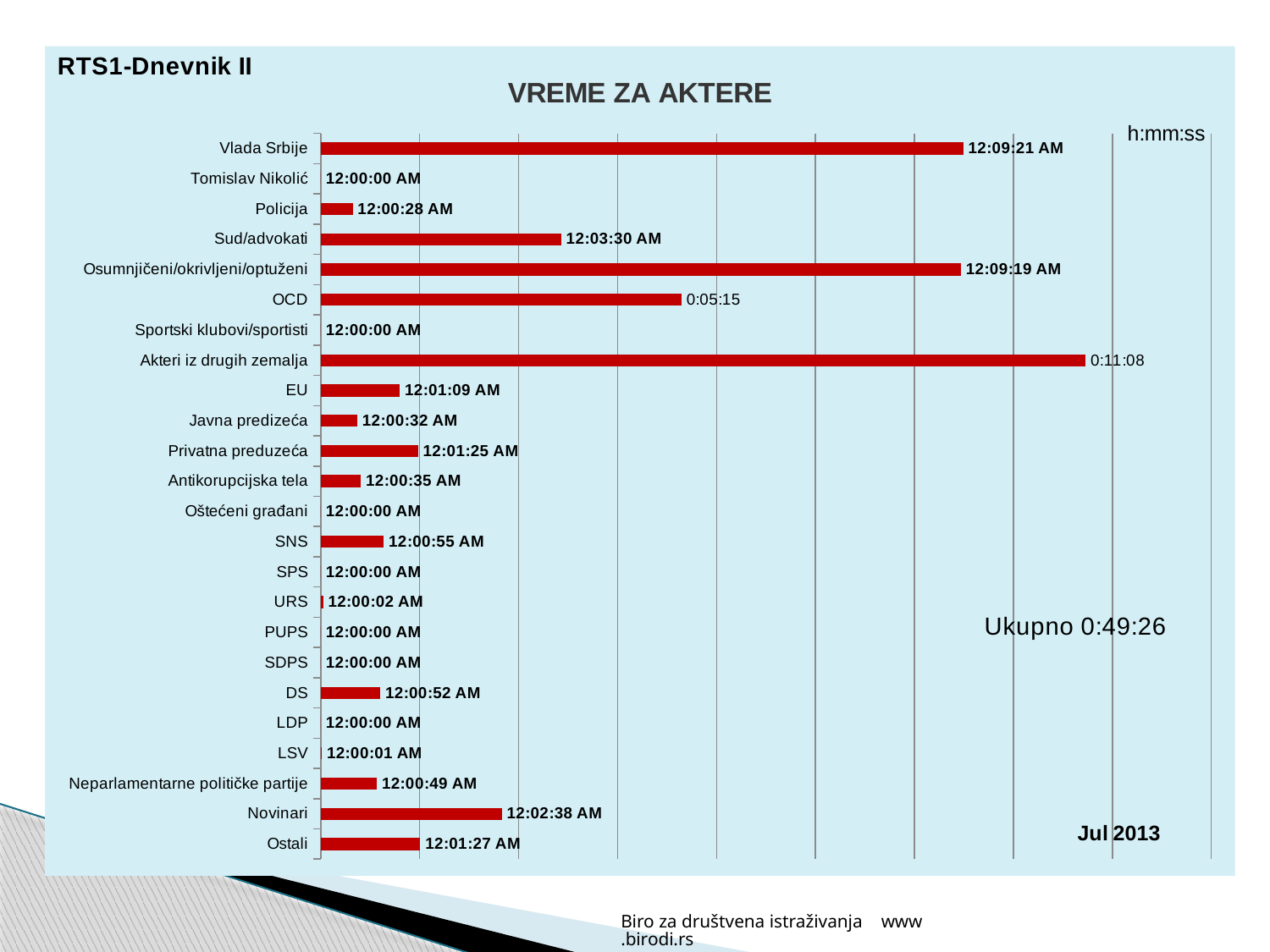
What is the value shown for Vlada Srbije? 12:09:21 AM What total (Ukupno) is printed on the chart? 0:49:26 What is the value shown for SNS? 12:00:55 AM What is the title of the chart? VREME ZA AKTERE Which has a larger value, Sud/advokati or OCD? OCD How many categories are plotted in the chart? 24 What is the value shown for Akteri iz drugih zemalja? 0:11:08 What is the value shown for OCD? 0:05:15 What kind of chart is shown on the slide? bar chart What is the value shown for Novinari? 12:02:38 AM Which category has the highest value in the chart? Akteri iz drugih zemalja What is the value shown for Sud/advokati? 12:03:30 AM